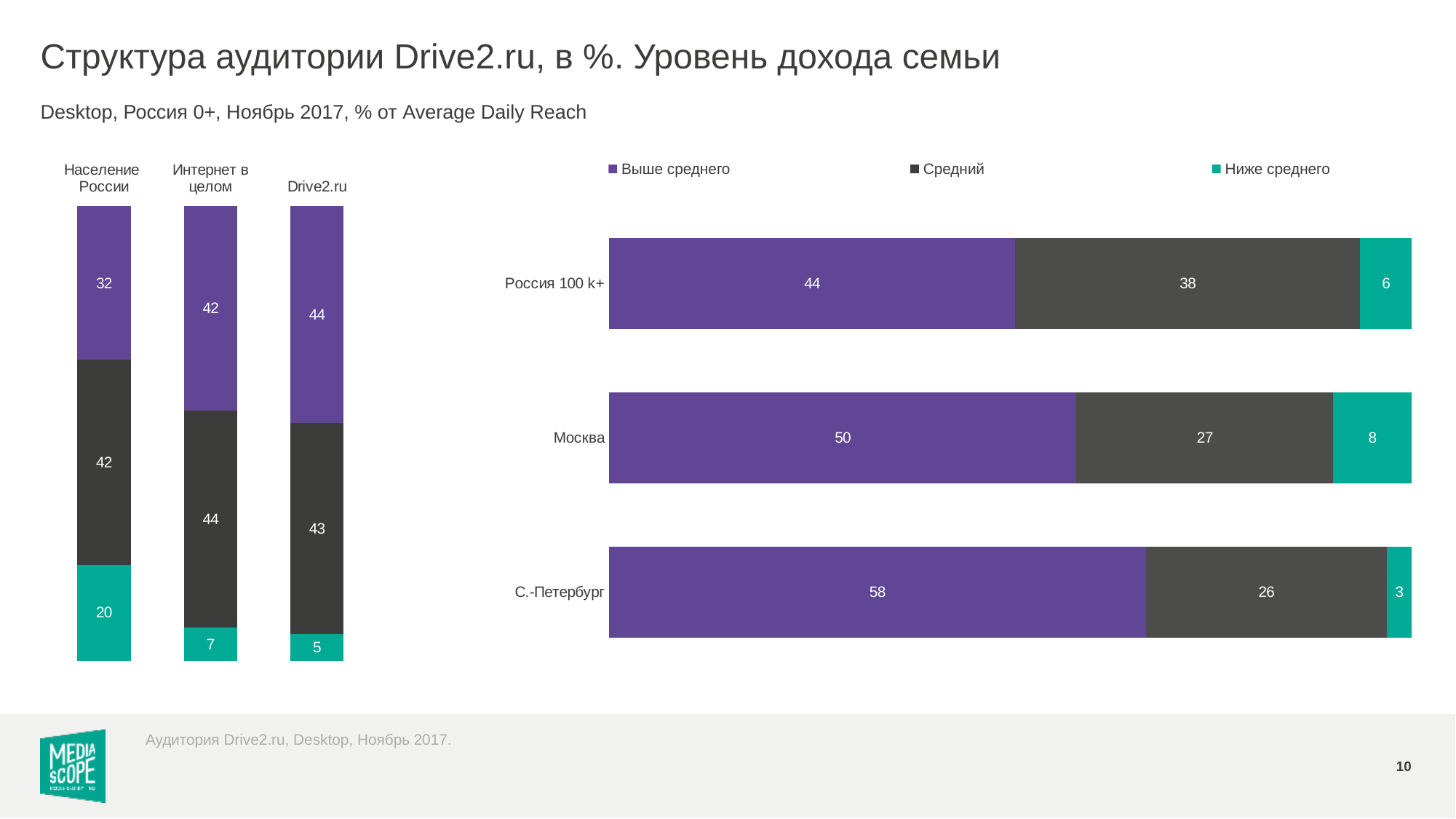
In the left chart, which category has the lowest 'Ниже среднего' value? Drive2.ru How many series does the legend list? 3 In the left chart, which is larger: the 'Средний' value for 'Интернет в целом' or for Drive2.ru? Интернет в целом In the right chart, what is the value of the 'Ниже среднего' segment for С.-Петербург? 3 What kind of chart is the right chart? Stacked bar chart In the right chart, what is the total of the stacked bar for Москва? 85 In the left chart, what is the value of the 'Ниже среднего' segment for 'Население России'? 20 In the right chart, what is the value of the 'Средний' segment for Москва? 27 How many categories are shown in the right chart? 3 In the left chart, what is the value of the 'Выше среднего' segment for Drive2.ru? 44 In the right chart, which category has the highest 'Выше среднего' value? С.-Петербург In the right chart, what is the difference between the 'Выше среднего' values for С.-Петербург and Россия 100 k+? 14